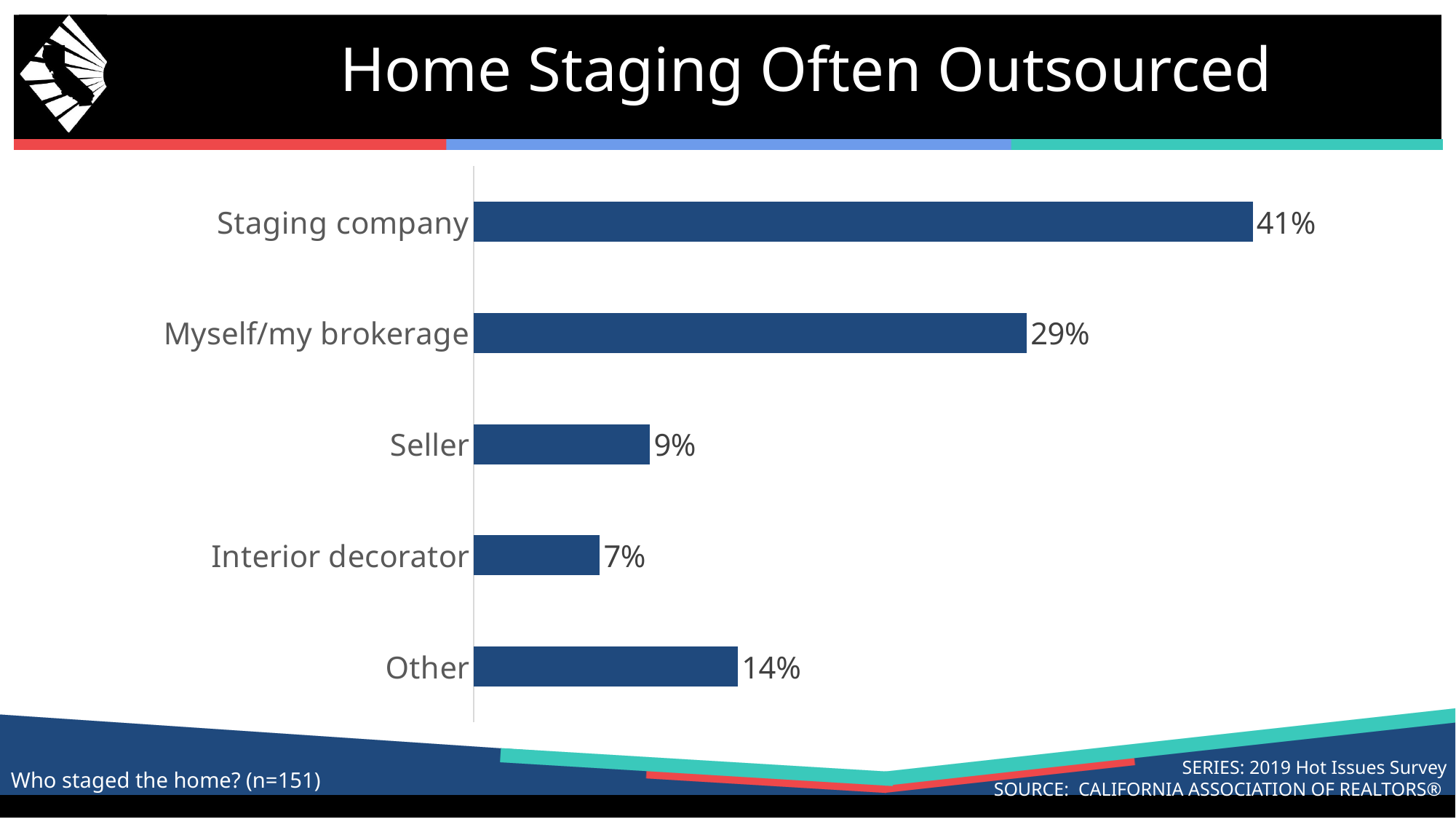
What is the difference between the values for Staging company and Myself/my brokerage? 12% What is the value for Myself/my brokerage? 29% Which is larger, the value for Seller or the value for Other? Other What is the value for Other? 14% What is the value for Seller? 9% What is the value for Interior decorator? 7% How many categories are shown in the chart? 5 What percentage of respondents said a staging company staged the home? 41% What is the title of the slide? Home Staging Often Outsourced Which category has the lowest value? Interior decorator Which category has the highest value? Staging company What kind of chart is shown on the slide? Bar chart